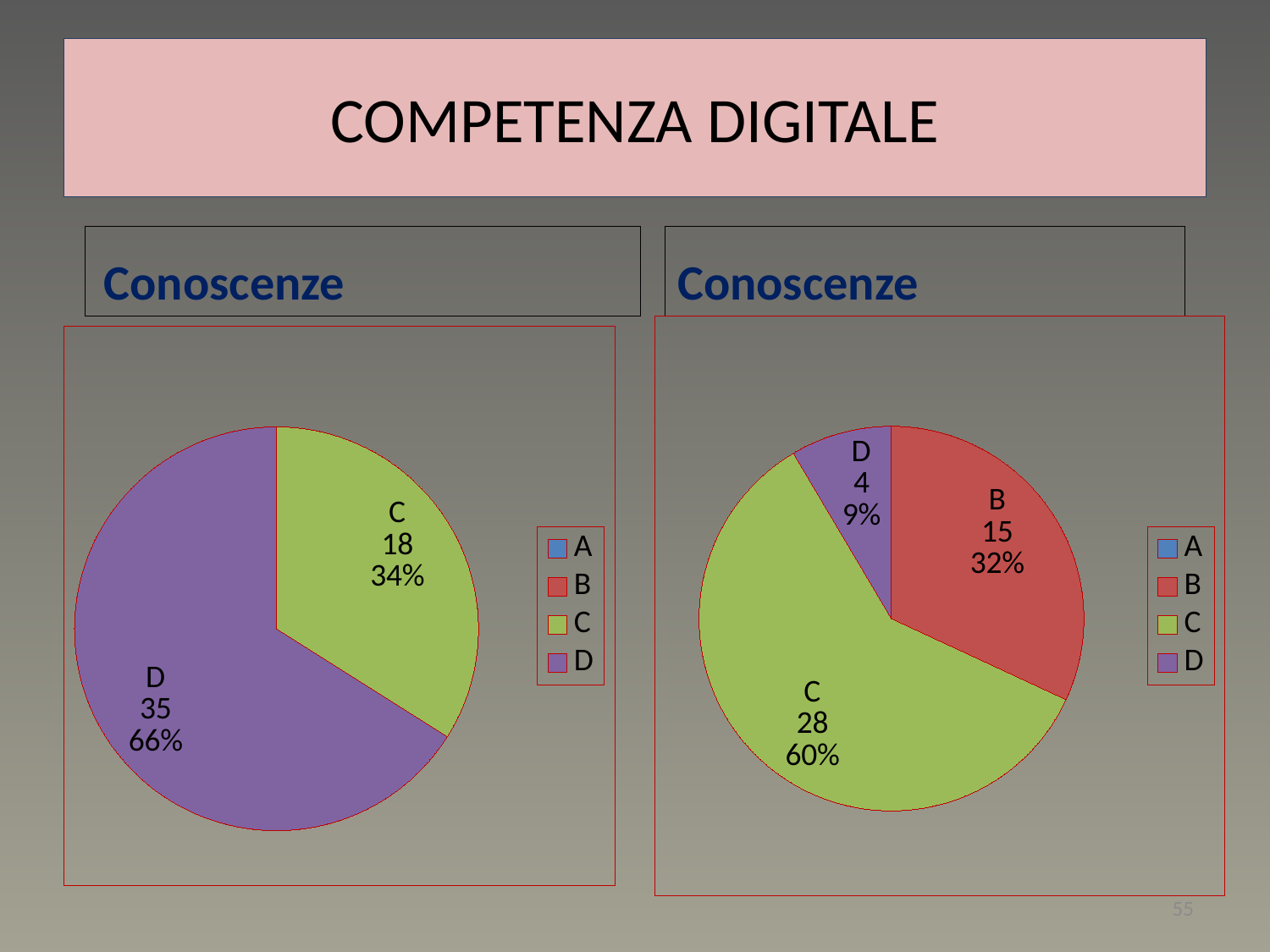
In the right pie chart, which category has the largest slice? C In the right pie chart, what is the value for category D? 4 What type of chart is shown on the right side of the slide? Pie chart In the right pie chart, which category has the smallest slice? D How many entries does the legend of the left chart list? 4 In the right pie chart, what is the value for category B? 15 In the right pie chart, what share of the pie does category C represent? 60% In the left pie chart, what is the value for category D? 35 In the left pie chart, which category has the largest slice? D In the left pie chart, what share of the pie does category C represent? 34% In the left pie chart, what is the difference between the values for D and C? 17 In the right pie chart, what is the difference between the values for C and B? 13